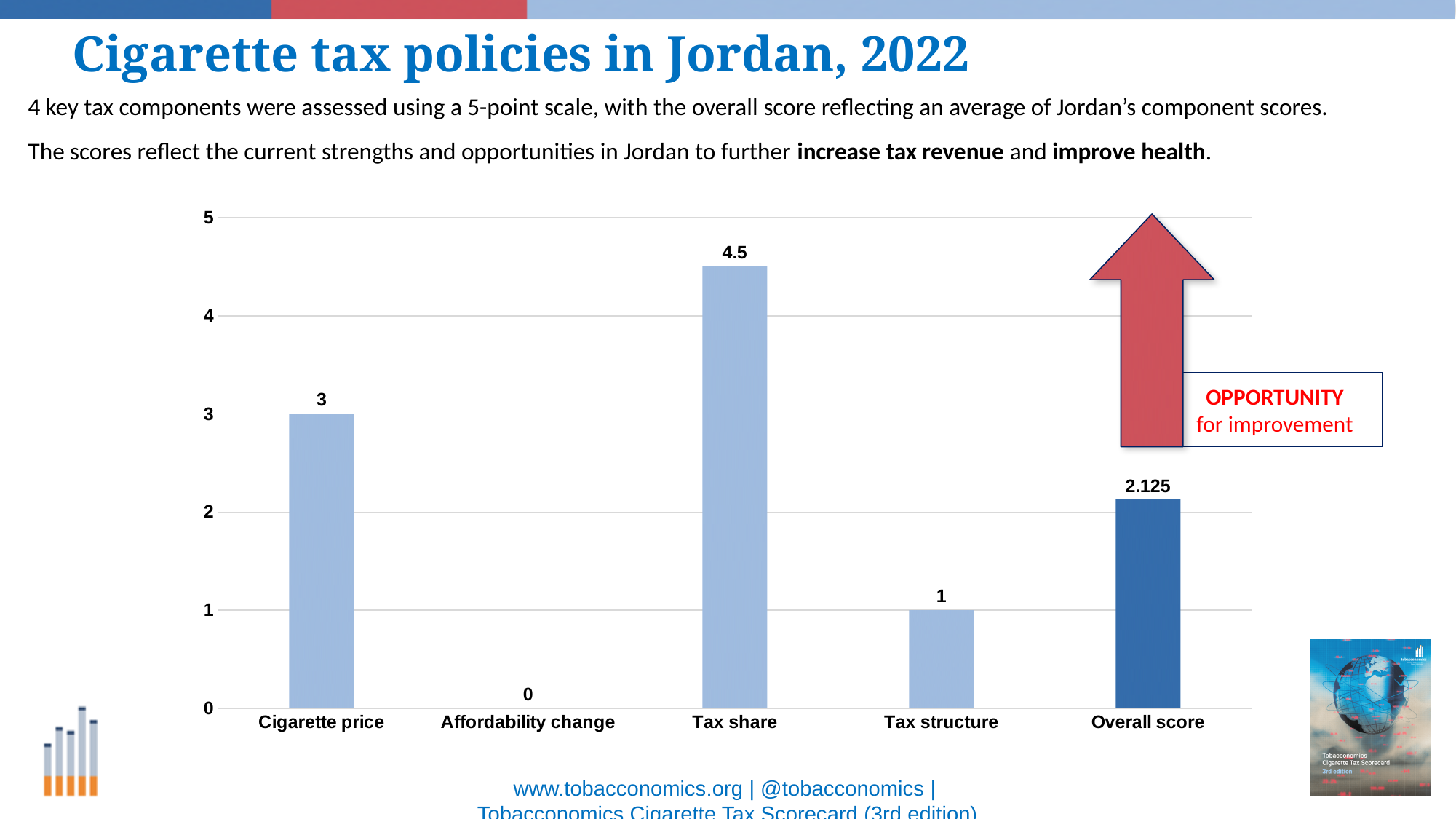
What is the value for Affordability change? 0 What is the value for Cigarette price? 3 What is the value for Tax share? 4.5 What is the Overall score? 2.125 How many categories are shown on the x axis? 5 Which category has the highest value? Tax share What kind of chart is shown on the slide? bar chart What is the difference between the values for Tax share and Tax structure? 3.5 Which is larger, the value for Cigarette price or the value for Tax structure? Cigarette price Which category has the lowest value? Affordability change Which bar is drawn in a darker blue than the others? Overall score Is the value for Overall score greater or less than 3? less